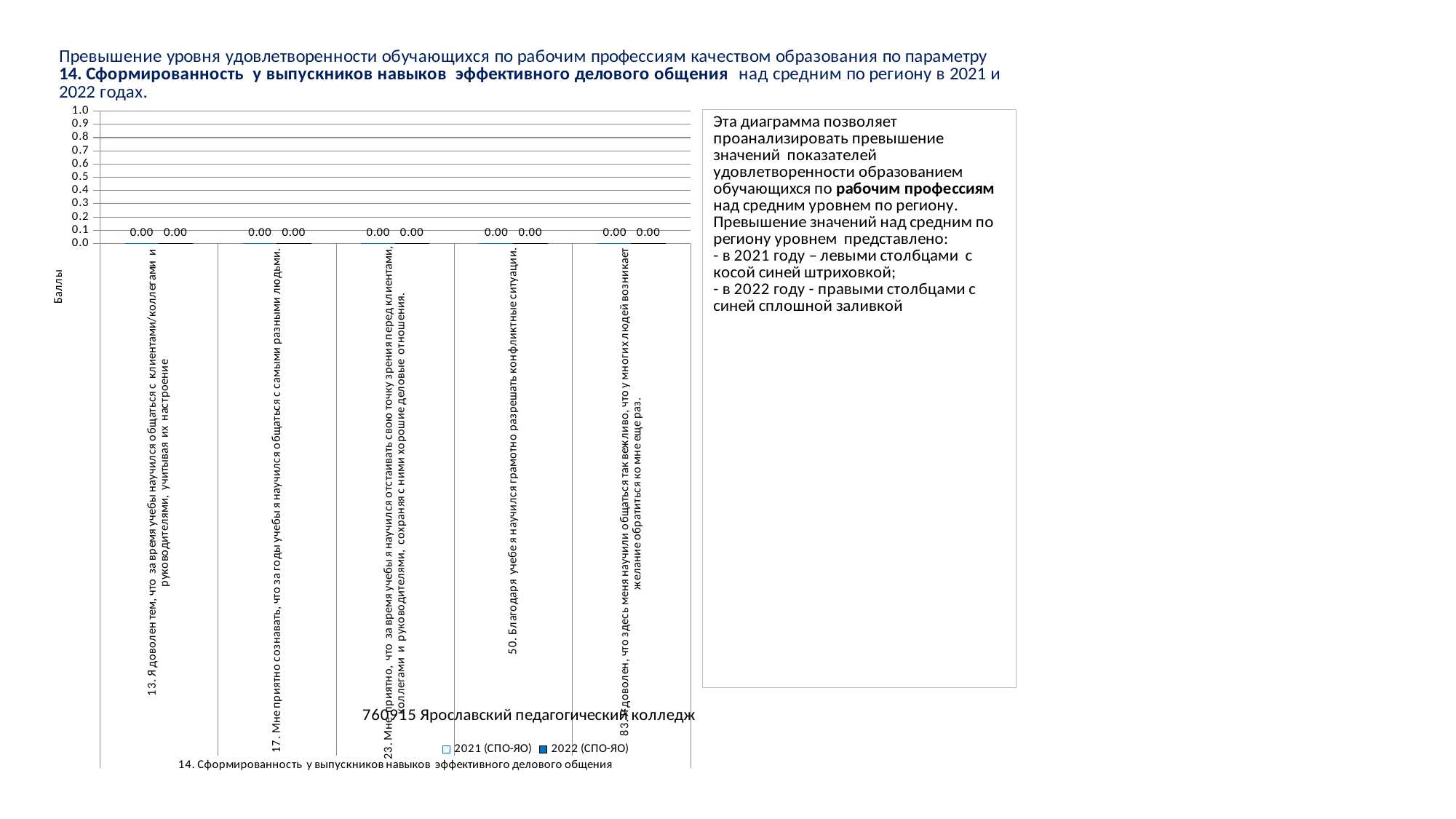
What is the value for the 2022 (СПО-ЯО) series for category 17 ("Мне приятно сознавать, что за годы учебы я научился общаться с самыми разными людьми")? 0.00 What is the highest value shown on the vertical axis of the chart? 1.0 How many categories are shown on the x axis of the chart? 5 Is the value for the 2022 (СПО-ЯО) series for category 13 greater or less than 0.5? less What kind of chart is shown on the slide? Bar chart What is the value for the 2022 (СПО-ЯО) series for category 50 ("Благодаря учебе я научился грамотно разрешать конфликтные ситуации")? 0.00 What is the value for the 2021 (СПО-ЯО) series for category 83 ("Я доволен, что здесь меня научили общаться так вежливо...")? 0.00 How many series does the chart legend list? 2 What is the label of the vertical axis of the chart? Баллы What are the two series names listed in the chart legend? 2021 (СПО-ЯО) and 2022 (СПО-ЯО) What is the value for the 2021 (СПО-ЯО) series for category 13 ("Я доволен тем, что за время учебы научился общаться с клиентами/коллегами и руководителями...")? 0.00 What is the difference between the 2021 (СПО-ЯО) and 2022 (СПО-ЯО) values for category 23? 0.00